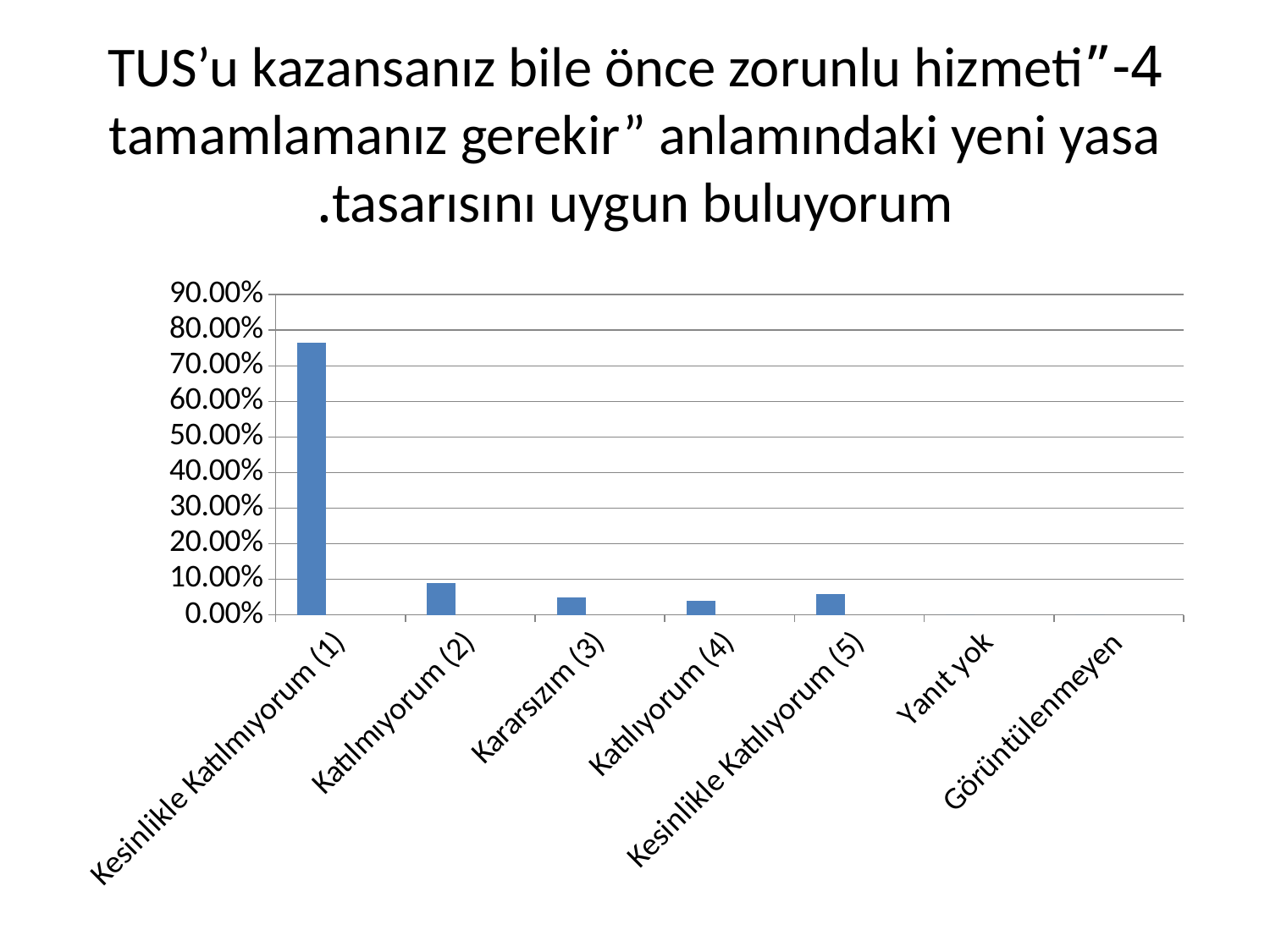
Is the value for Kararsızım (3) greater or less than 10.00%? less What kind of chart is shown on the slide? bar chart What colour are the bars in the chart? blue Which is larger, the value for Kesinlikle Katılmıyorum (1) or the value for Kesinlikle Katılıyorum (5)? Kesinlikle Katılmıyorum (1) Is the value for Kesinlikle Katılıyorum (5) greater or less than 20.00%? less Is the value for Kesinlikle Katılmıyorum (1) greater or less than 70.00%? greater How many categories are shown on the x axis of the chart? 7 Which category has the highest value in the chart? Kesinlikle Katılmıyorum (1) What is the highest value shown on the y axis of the chart? 90.00% Which is larger, the value for Katılmıyorum (2) or the value for Kararsızım (3)? Katılmıyorum (2)